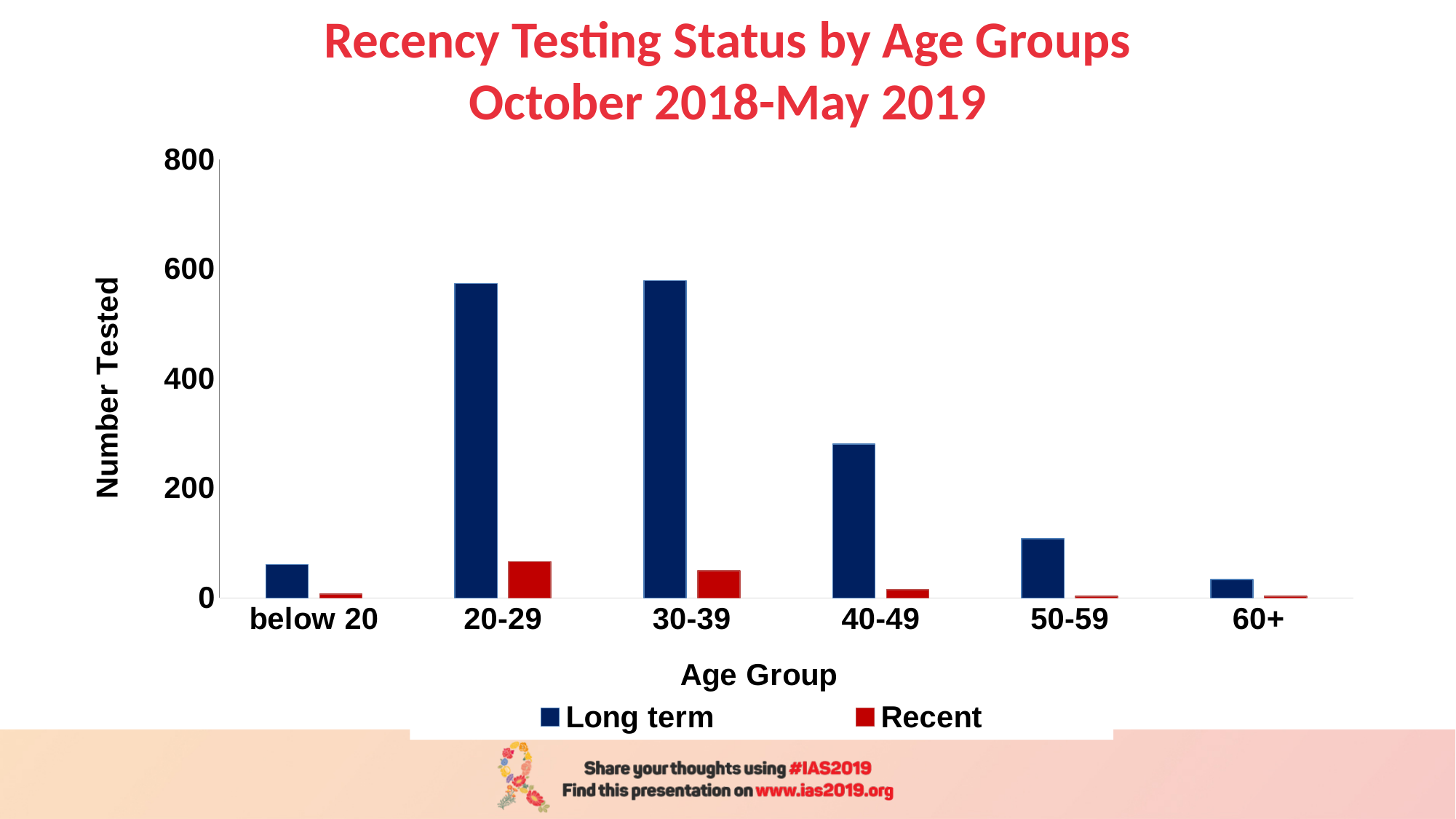
Which age group has the highest Recent value? 20-29 How many series does the legend list? 2 Is the Long term value for 20-29 greater or less than 400? greater Is the Long term value for 40-49 greater or less than 200? greater How many age groups are shown on the x axis? 6 Which age group has the lowest Long term value? 60+ Is the Recent value for 30-39 greater or less than 200? less Which is larger, the Long term value for 40-49 or the Long term value for 50-59? 40-49 What is the label of the y axis? Number Tested What kind of chart is shown on the slide? bar chart Which colour represents the Recent series in the legend? red